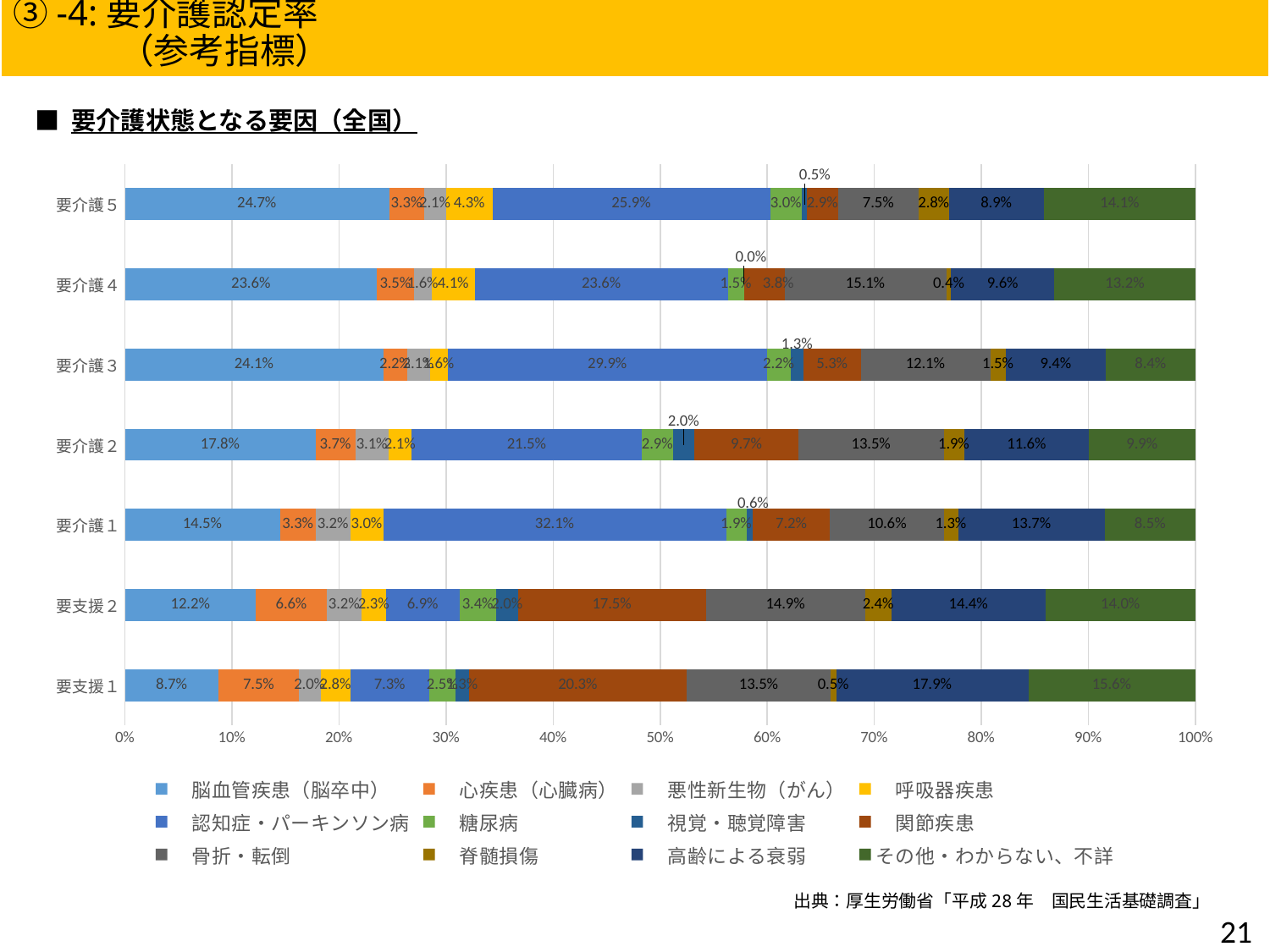
Which care level has the lowest value for 脳血管疾患（脳卒中）? 要支援1 What is the value of 高齢による衰弱 for 要支援2? 14.4% What is the difference between the 骨折・転倒 values for 要介護4 and 要介護1? 4.5% Which care level has the highest value for 認知症・パーキンソン病? 要介護1 What kind of chart is shown on the slide? Stacked bar chart What is the value of 認知症・パーキンソン病 for 要介護1? 32.1% What is the value of 脳血管疾患（脳卒中） for 要介護5? 24.7% What is the value of 関節疾患 for 要支援1? 20.3% What is the title of the chart? 要介護状態となる要因（全国） Which is larger for 要介護2: 関節疾患 or 骨折・転倒? 骨折・転倒 How many categories (care levels) are plotted on the chart? 7 How many series does the legend list? 12